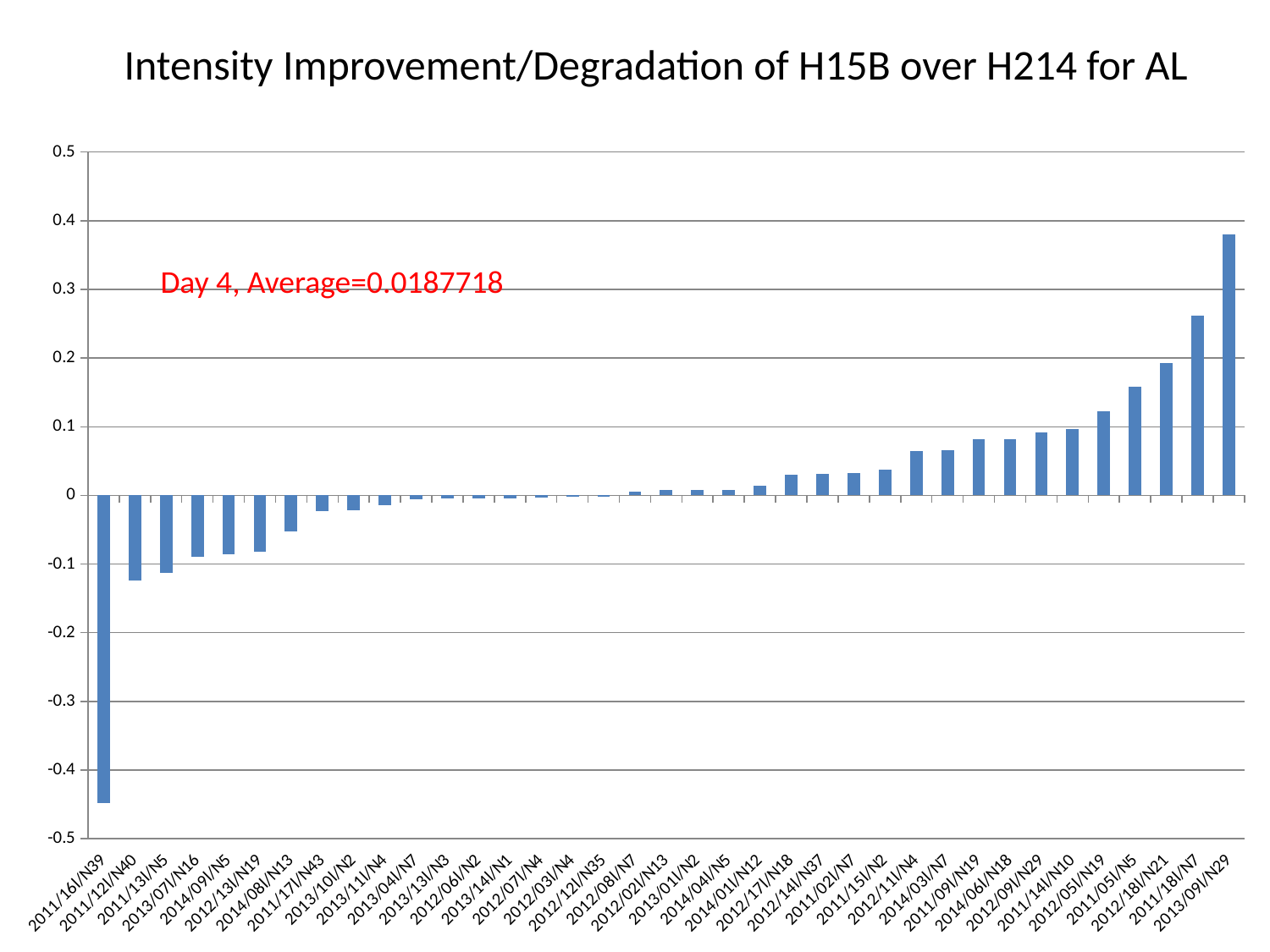
Is the value for 2011/18/N7 greater or less than 0.2? greater Which category has the lowest value? 2011/16l/N39 Is the value for 2011/16/N39 greater or less than -0.4? less Is the value for 2011/12/N40 greater or less than -0.1? less What average value is stated in the red annotation on the chart? 0.0187718 What kind of chart is shown on the slide? bar chart How many categories are plotted on the x axis? 37 Do the values generally rise or fall from left to right along the x axis? rise Which category has the highest value? 2013/09l/N29 Which has the larger value, 2011/18/N7 or 2012/18/N21? 2011/18/N7 What is the title of the chart? Intensity Improvement/Degradation of H15B over H214 for AL